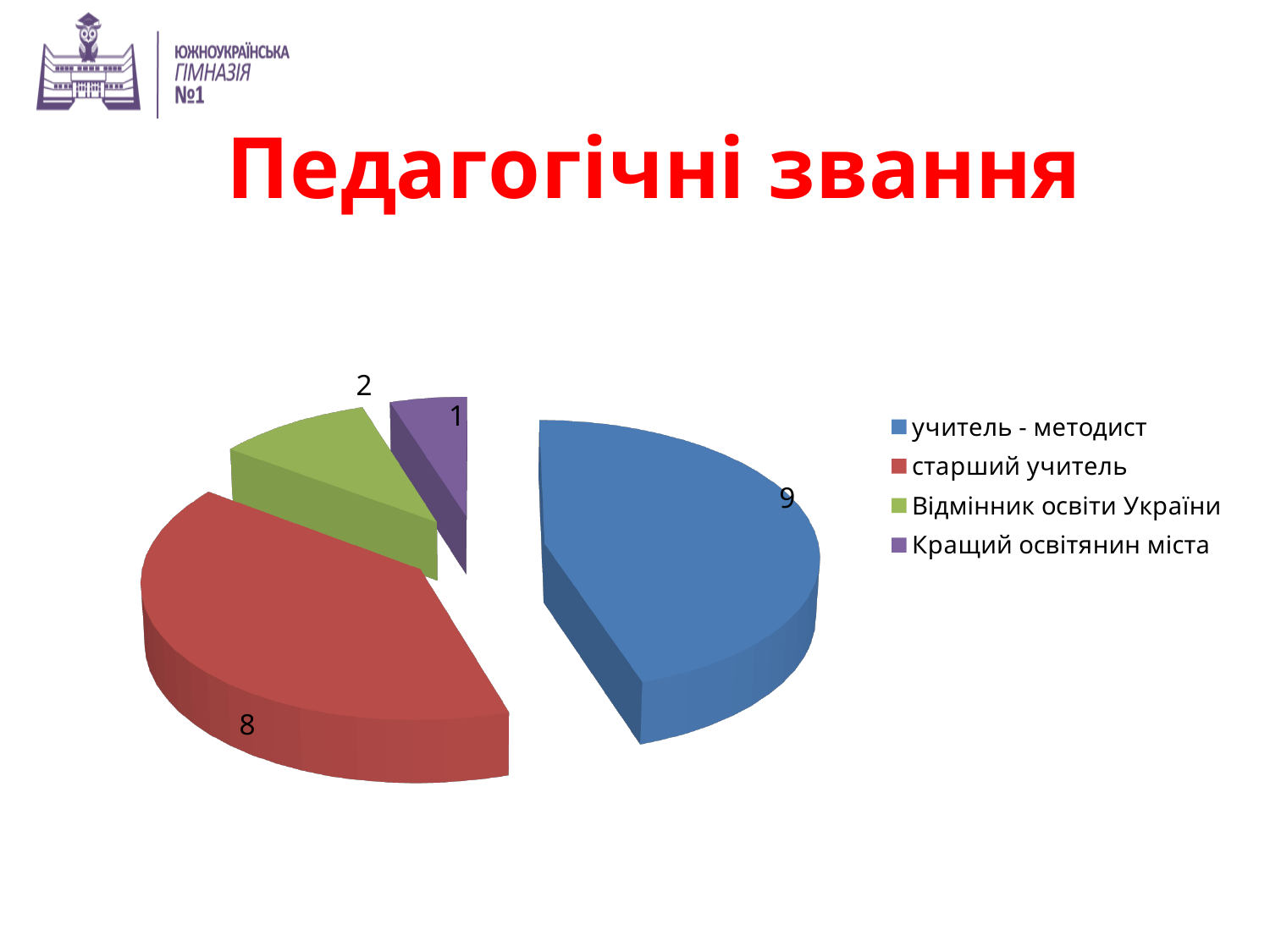
What is the value for Кращий освітянин міста? 1 What is the value for старший учитель? 8 What share of the pie does учитель - методист represent? 45% Which category has the smallest slice of the pie? Кращий освітянин міста How many categories does the pie chart show? 4 What is the difference between the values for учитель - методист and старший учитель? 1 Which is larger, the value for Відмінник освіти України or the value for Кращий освітянин міста? Відмінник освіти України What is the title of the slide containing the chart? Педагогічні звання What is the value for Відмінник освіти України? 2 What is the value for учитель - методист? 9 What type of chart is shown on the slide? pie chart Which category has the largest slice of the pie? учитель - методист